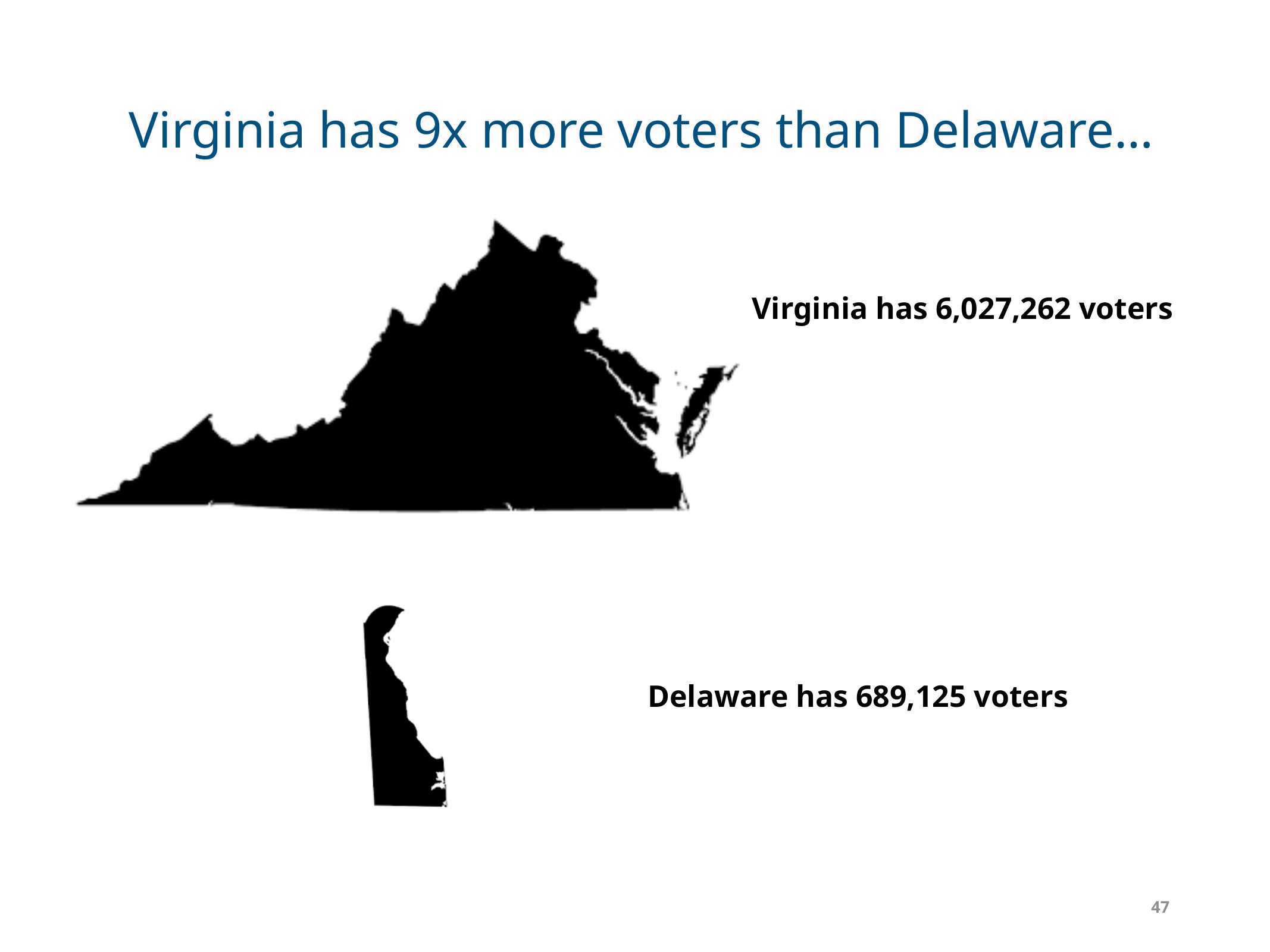
Which of the two states shown has the most voters? Virginia How many states are compared on the slide? 2 Which state has more voters, Virginia or Delaware? Virginia What is the difference between Virginia's and Delaware's voter counts? 5,338,137 How many voters does Virginia have according to the slide? 6,027,262 Which of the two states shown has the fewest voters? Delaware How many voters does Delaware have according to the slide? 689,125 According to the slide title, how many times more voters does Virginia have than Delaware? 9x What is the title of the slide? Virginia has 9x more voters than Delaware...